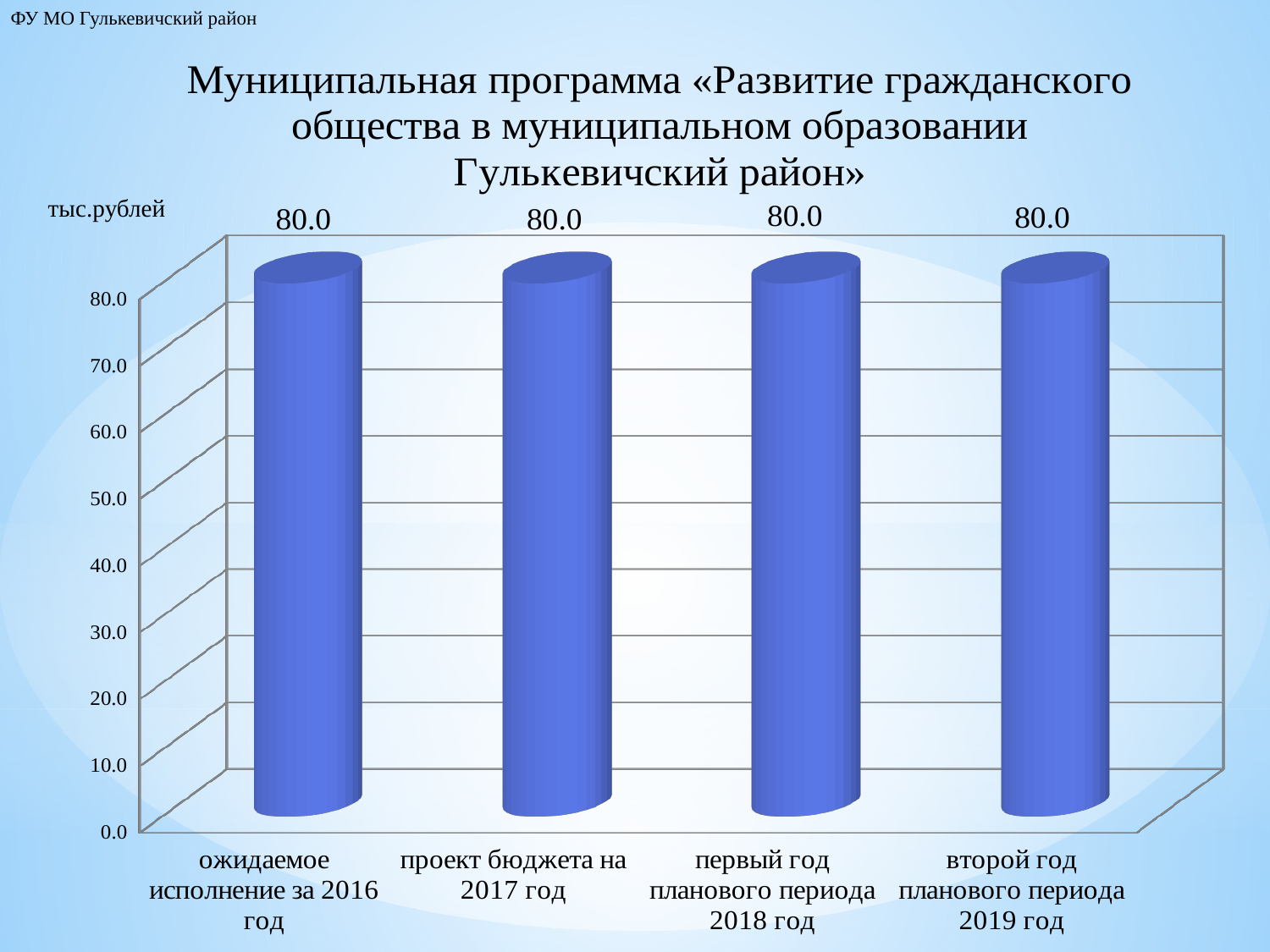
What unit of measurement is indicated above the vertical axis? тыс.рублей What is the value for «второй год планового периода 2019 год»? 80.0 What is the value for «первый год планового периода 2018 год»? 80.0 Do the values rise, fall or stay the same from 2016 to 2019? stay the same How many categories are shown on the x axis? 4 What is the title of the chart? Муниципальная программа «Развитие гражданского общества в муниципальном образовании Гулькевичский район» Is the value for «первый год планового периода 2018 год» greater or less than 70.0? greater Is the value for «второй год планового периода 2019 год» greater or less than 50.0? greater What is the value for «ожидаемое исполнение за 2016 год»? 80.0 What is the difference between the value for «проект бюджета на 2017 год» and the value for «ожидаемое исполнение за 2016 год»? 0.0 What is the value for «проект бюджета на 2017 год»? 80.0 What kind of chart is shown on the slide? bar chart